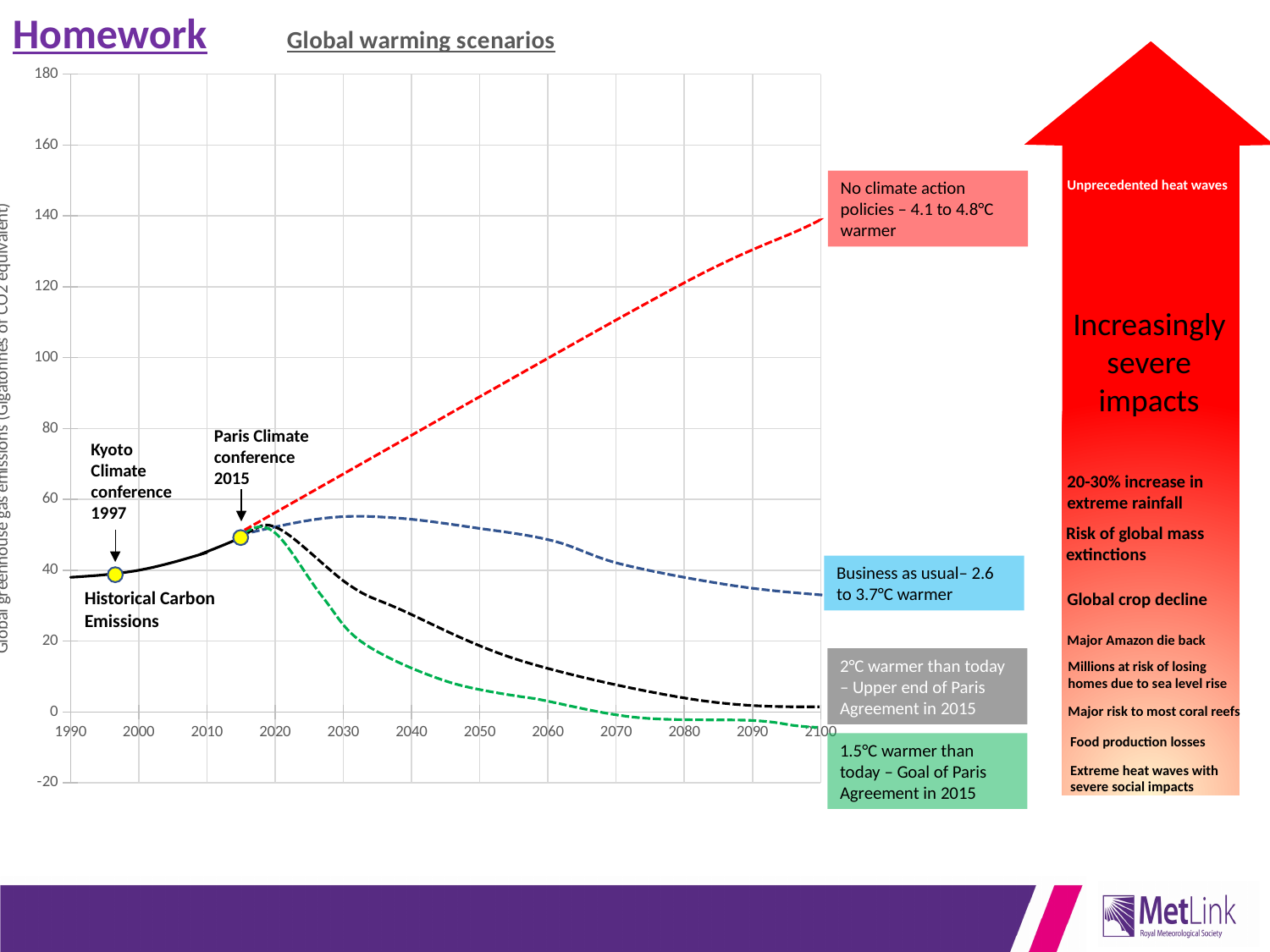
Is the value of the 'No climate action policies' line in 2050 greater or less than 80? greater How many future emissions scenarios are labelled in the coloured boxes to the right of the chart? 4 Which scenario line has the lowest emissions value in 2100? 1.5°C warmer than today In 2100, which is larger: the 'No climate action policies' value or the 'Business as usual' value? No climate action policies Does the 'No climate action policies' line rise or fall between 2020 and 2100? rise Which scenario line has the highest emissions value in 2100? No climate action policies What is the title of the chart? Global warming scenarios Does the '1.5°C warmer than today' line rise or fall between 2020 and 2060? fall Is the value of the 'No climate action policies' line in 2100 greater or less than 120? greater Is the value of the '2°C warmer than today' line in 2100 greater or less than 20? less What kind of chart is used to show the global warming scenarios? line chart